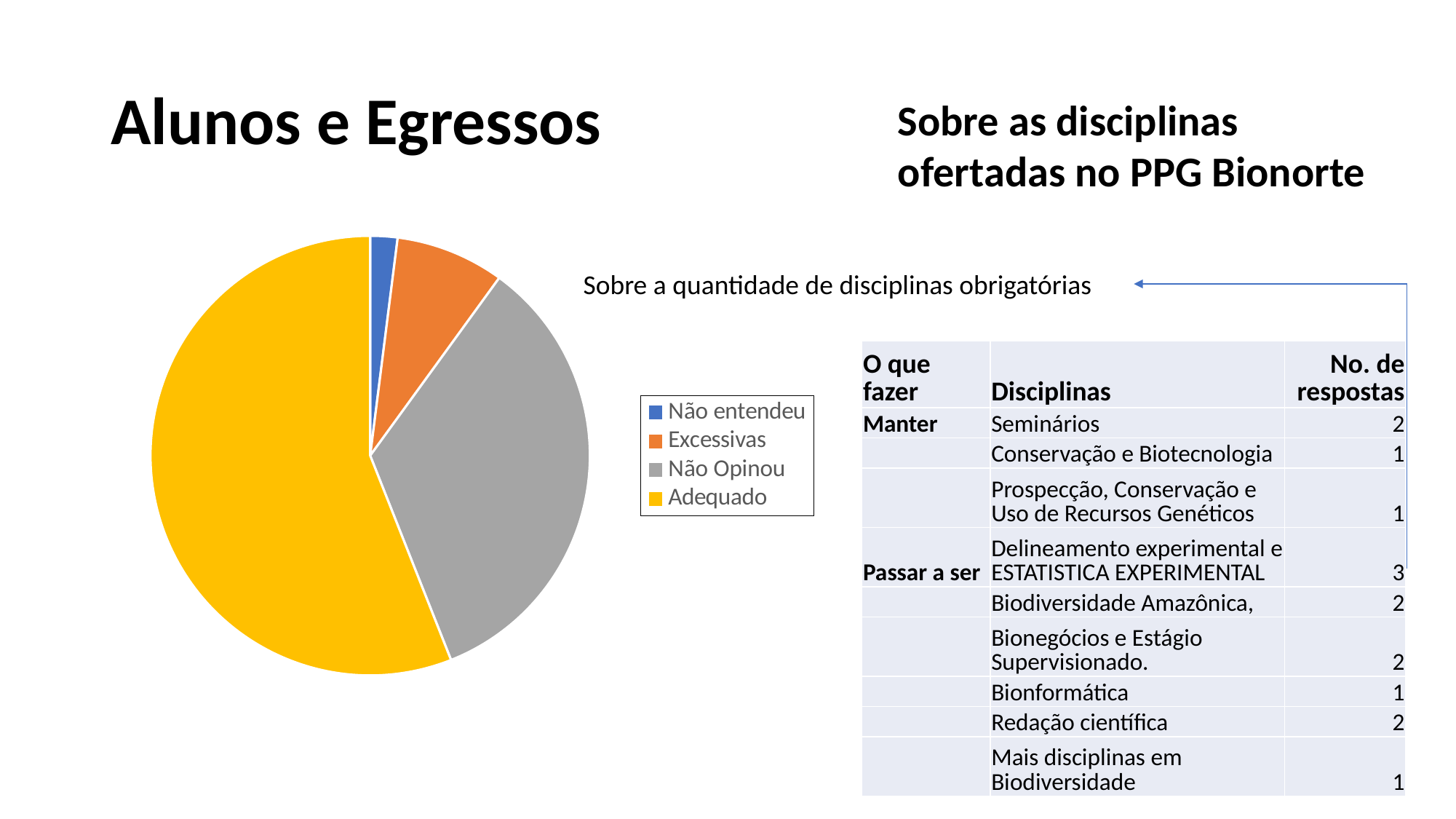
Which slice is larger in the pie chart, Não Opinou or Excessivas? Não Opinou Which category has the second-largest slice in the pie chart? Não Opinou Which category has the smallest slice in the pie chart? Não entendeu What colour is the Adequado slice in the pie chart? yellow Which slice is larger in the pie chart, Excessivas or Não entendeu? Excessivas What kind of chart is shown on the slide? pie chart Which slice is larger in the pie chart, Adequado or Não Opinou? Adequado What is the caption shown next to the pie chart describing what it is about? Sobre a quantidade de disciplinas obrigatórias How many entries does the legend of the pie chart list? 4 How many slices does the pie chart have? 4 Which category has the largest slice in the pie chart? Adequado